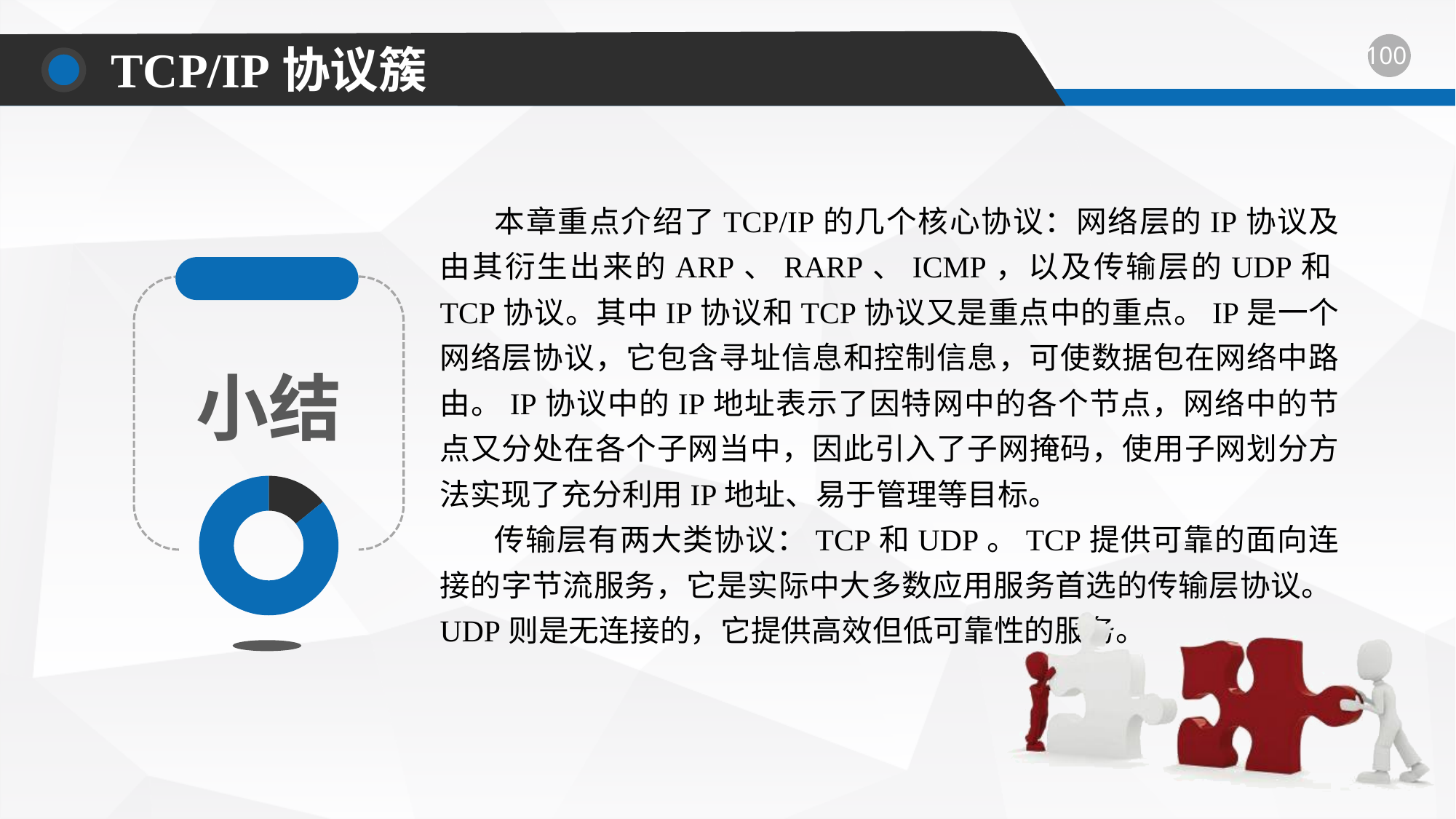
What kind of chart is shown on the left of the slide below the word 小结? doughnut chart In the doughnut chart on the left of the slide, which segment is larger, the blue one or the dark grey one? the blue one Does the doughnut chart on the left of the slide show any data labels or a legend? No What colour is the larger segment of the doughnut chart on the left of the slide? blue How many segments does the doughnut chart on the left of the slide have? 2